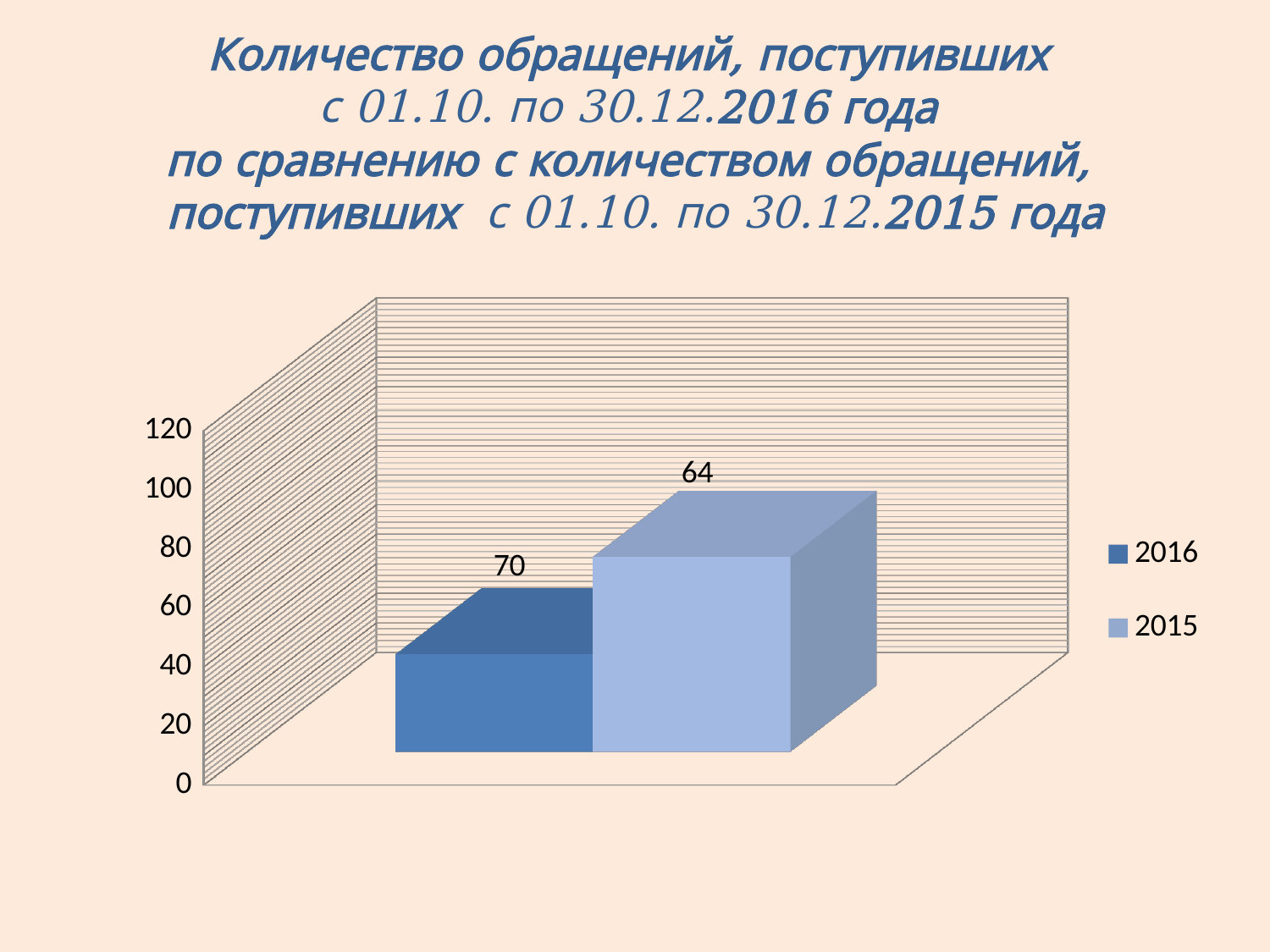
Which series is shown in the lighter blue colour? 2015 What is the maximum value shown on the vertical axis? 120 What is the difference between the value for 2016 and the value for 2015? 6 What kind of chart is shown on the slide? bar chart What is the value for 2015? 64 Which series has the higher value according to the data labels, 2016 or 2015? 2016 What is the value for 2016? 70 How many series does the legend list? 2 Is the value for 2015 greater or less than 100? less